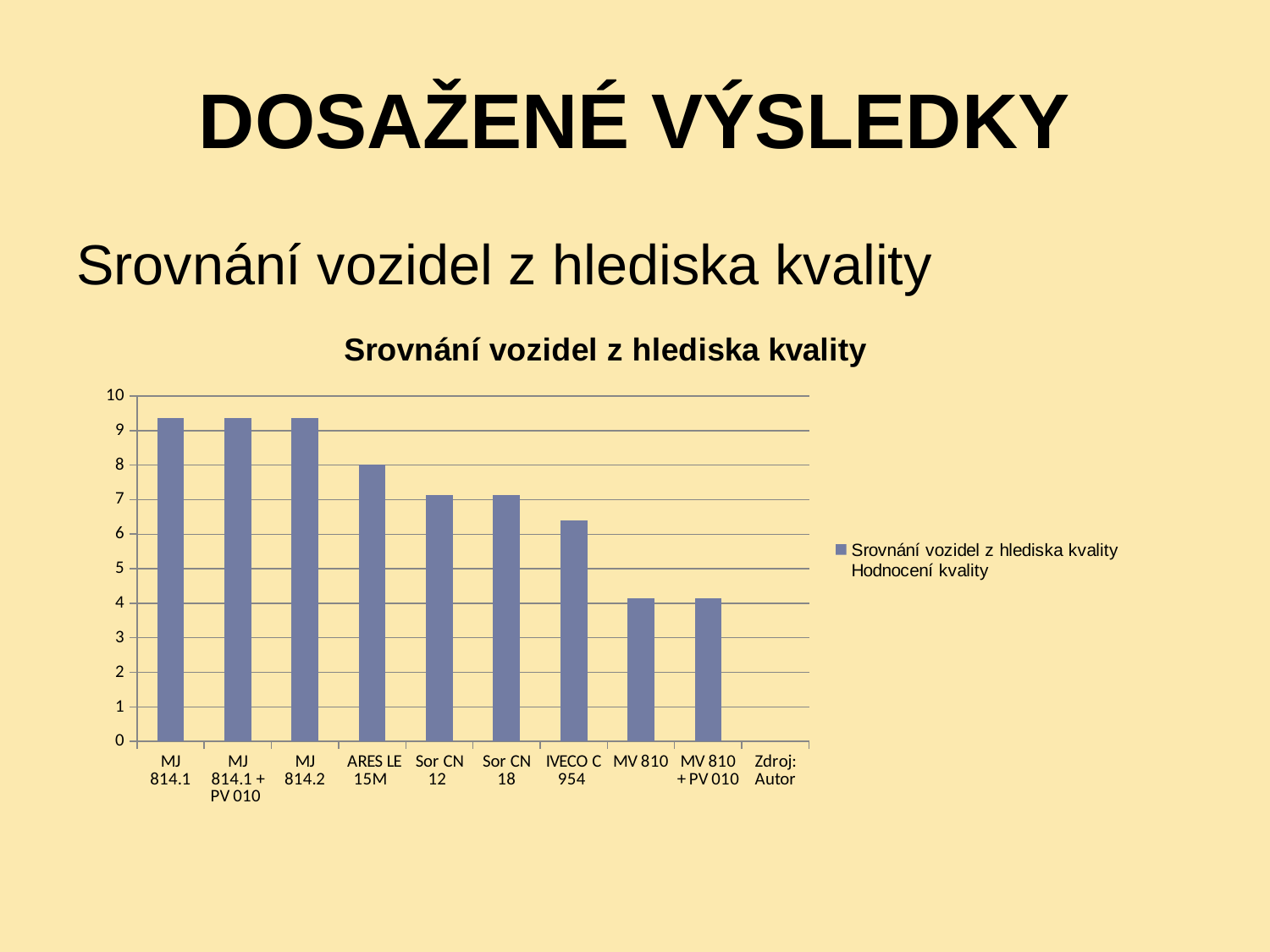
Is the value for IVECO C 954 greater or less than 6? greater Is the value for Sor CN 12 greater or less than 8? less Is the value for MJ 814.1 greater or less than 9? greater Which has the larger value, ARES LE 15M or Sor CN 18? ARES LE 15M What is the title of the chart? Srovnání vozidel z hlediska kvality Which has the larger value, MJ 814.2 or IVECO C 954? MJ 814.2 How many series does the legend list? 1 How many bars are plotted in the chart? 9 What is the last label shown on the x axis of the chart? Zdroj: Autor What kind of chart is shown on the slide? bar chart Do the bar values generally rise or fall from left to right along the x axis? fall